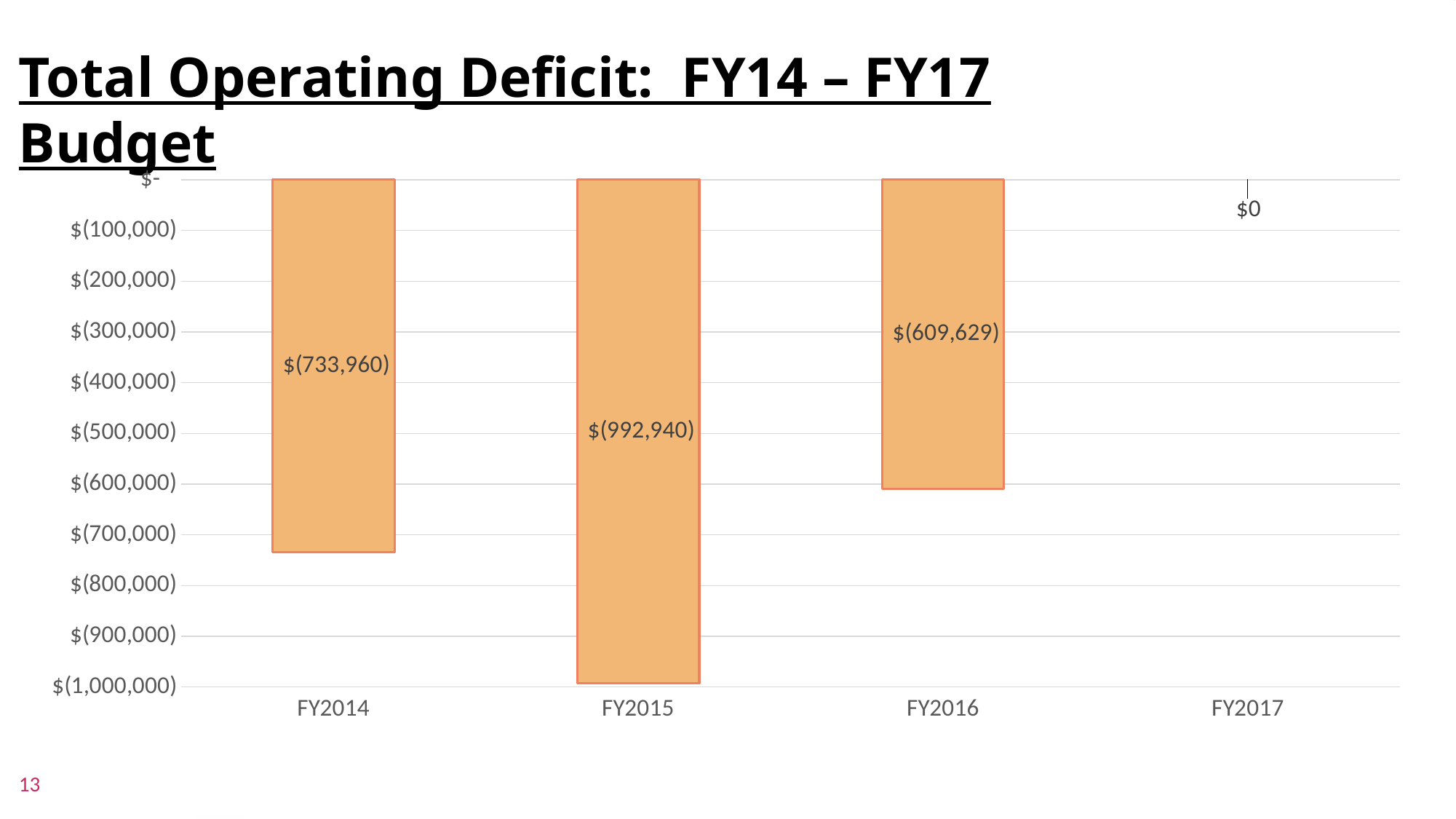
What is the value for FY2014? $(733,960) By how much does the deficit in FY2014 exceed the deficit in FY2016? $124,331 How many fiscal years are shown on the x axis? 4 What is the value for FY2017? $0 Which fiscal year has the highest value on the chart? FY2017 What is the value for FY2016? $(609,629) What kind of chart is shown on the slide? Bar chart Which has the larger deficit, FY2014 or FY2016? FY2014 Which fiscal year has the largest operating deficit (the lowest value)? FY2015 What is the title of the slide? Total Operating Deficit: FY14 – FY17 Budget By how much does the deficit in FY2015 exceed the deficit in FY2014? $258,980 What is the value for FY2015? $(992,940)